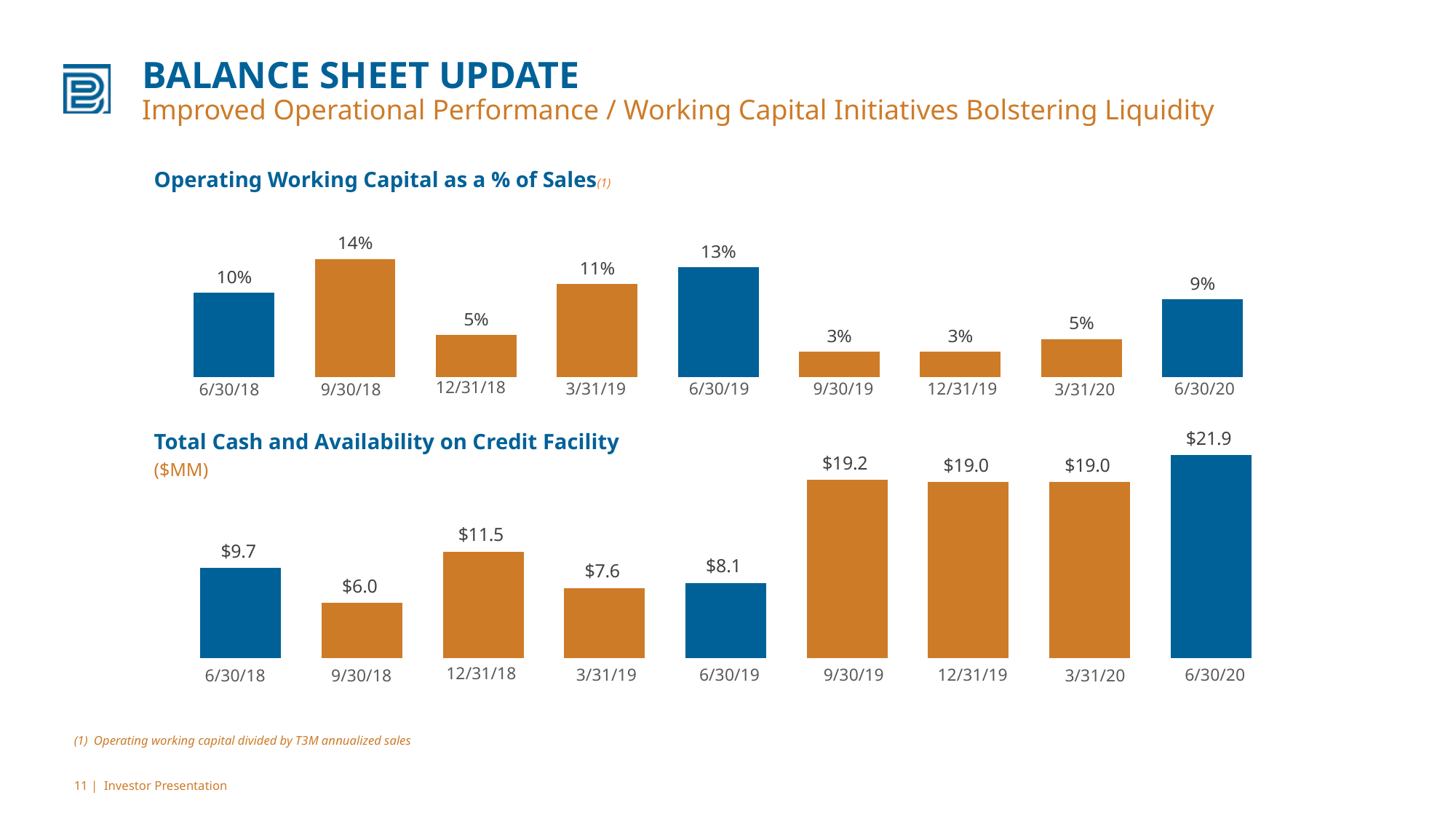
In the 'Total Cash and Availability on Credit Facility' chart, what unit is shown under the title? $MM What kind of chart is the 'Total Cash and Availability on Credit Facility' chart? Bar chart In the 'Total Cash and Availability on Credit Facility' chart, which date has the lowest value? 9/30/18 In the 'Total Cash and Availability on Credit Facility' chart, what is the difference between the values for 6/30/20 and 9/30/19? $2.7 In the 'Total Cash and Availability on Credit Facility' chart, what is the value for 12/31/18? $11.5 In the 'Total Cash and Availability on Credit Facility' chart, which is larger, the value for 6/30/18 or the value for 6/30/19? 6/30/18 In the 'Operating Working Capital as a % of Sales' chart, what is the difference between the values for 6/30/19 and 9/30/19? 10% In the 'Operating Working Capital as a % of Sales' chart, which date has the highest value? 9/30/18 In the 'Operating Working Capital as a % of Sales' chart, what is the value for 6/30/20? 9% In the 'Operating Working Capital as a % of Sales' chart, how many dates are shown? 9 In the 'Total Cash and Availability on Credit Facility' chart, which date has the highest value? 6/30/20 In the 'Operating Working Capital as a % of Sales' chart, what is the value for 9/30/18? 14%